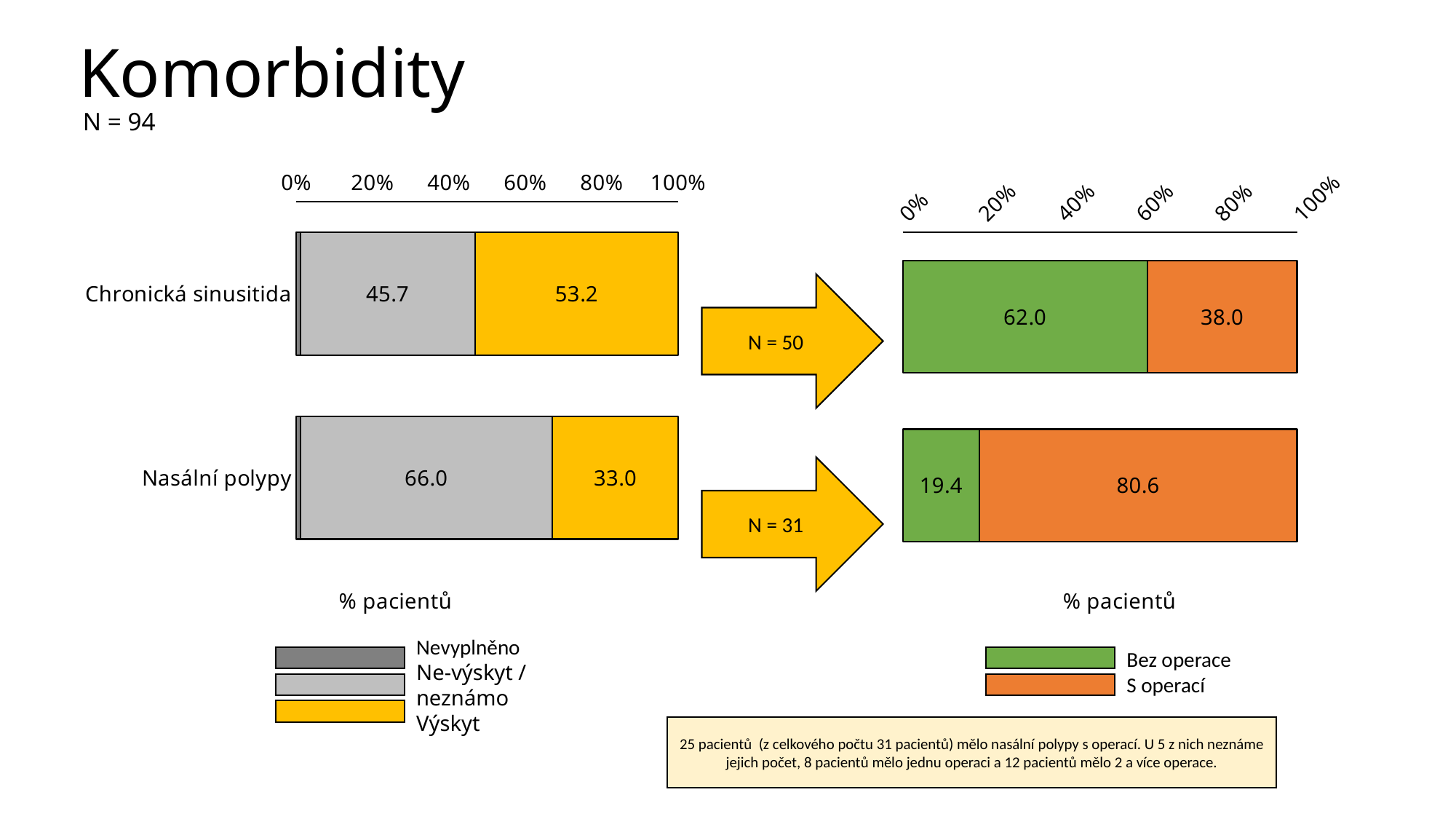
What kind of chart is the right chart? stacked bar chart In the left chart, what is the Výskyt value for Chronická sinusitida? 53.2 In the left chart, what is the difference between the Ne-výskyt / neznámo values for Nasální polypy and Chronická sinusitida? 20.3 What is the axis title shown below the left chart? % pacientů In the left chart, what is the Ne-výskyt / neznámo value for Nasální polypy? 66.0 In the left chart, which category has the higher Výskyt value? Chronická sinusitida In the right chart, what is the difference between the S operací values for Nasální polypy and Chronická sinusitida? 42.6 In the right chart, what is the Bez operace value for the Chronická sinusitida bar? 62.0 How many series does the legend of the left chart list? 3 In the right chart, which bar has the lower Bez operace value? Nasální polypy In the right chart, is the S operací value for Chronická sinusitida larger or smaller than its Bez operace value? smaller In the right chart, what is the S operací value for the Nasální polypy bar? 80.6